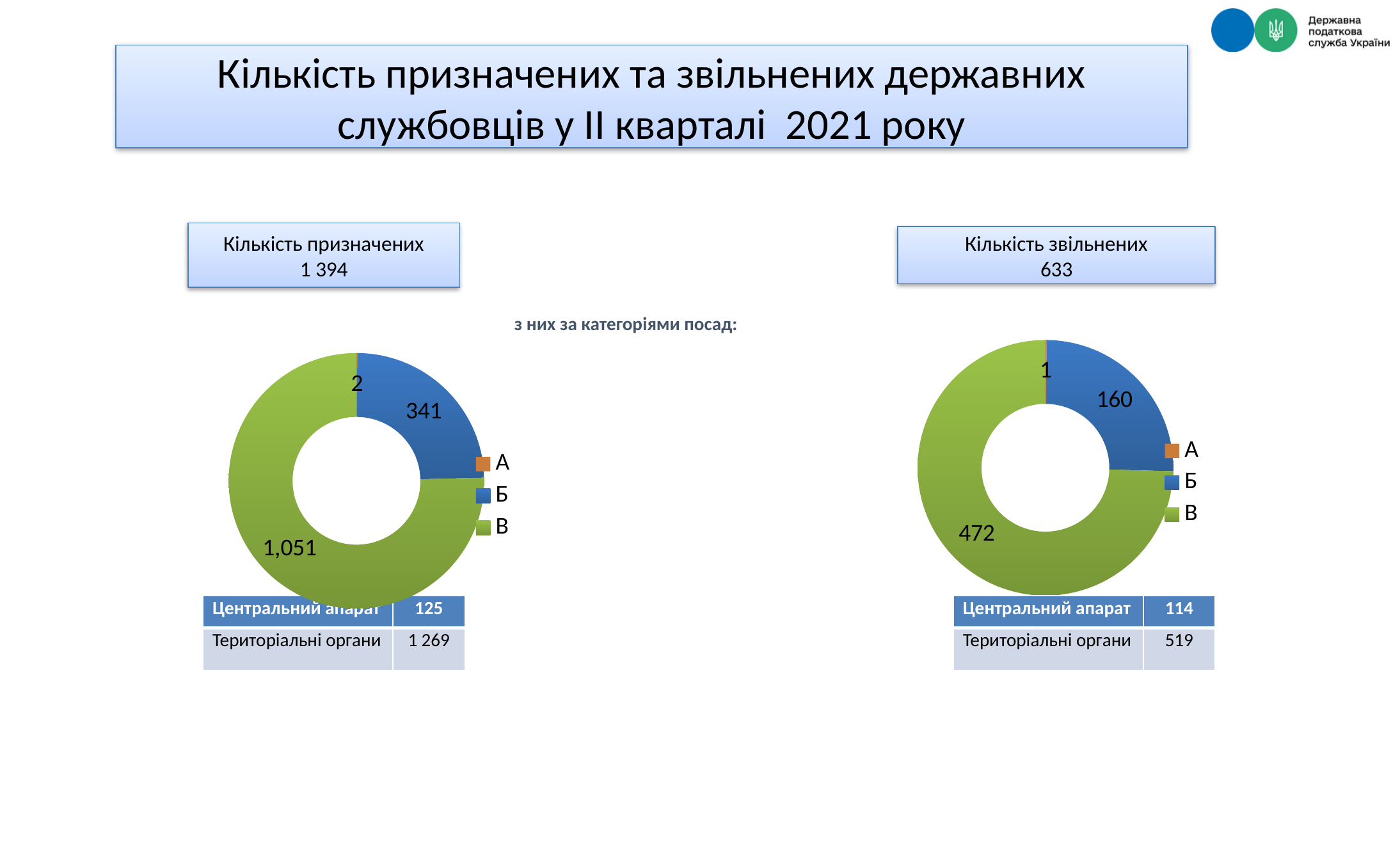
In the right chart, what is the difference between the values for В and Б? 312 In the left chart, what is the value for category В? 1,051 In the right chart, which is larger, the value for Б or the value for В? В In the left chart, what is the value for category Б? 341 In the left chart, what is the difference between the values for В and Б? 710 In the left chart, which category has the largest slice? В In the left chart, what is the value for category А? 2 In the right chart, what is the value for category В? 472 In the right chart, which category has the smallest slice? А How many categories does the legend of the right chart list? 3 What kind of chart is the left chart on the slide? Doughnut (pie) chart In the right chart, what is the value for category Б? 160